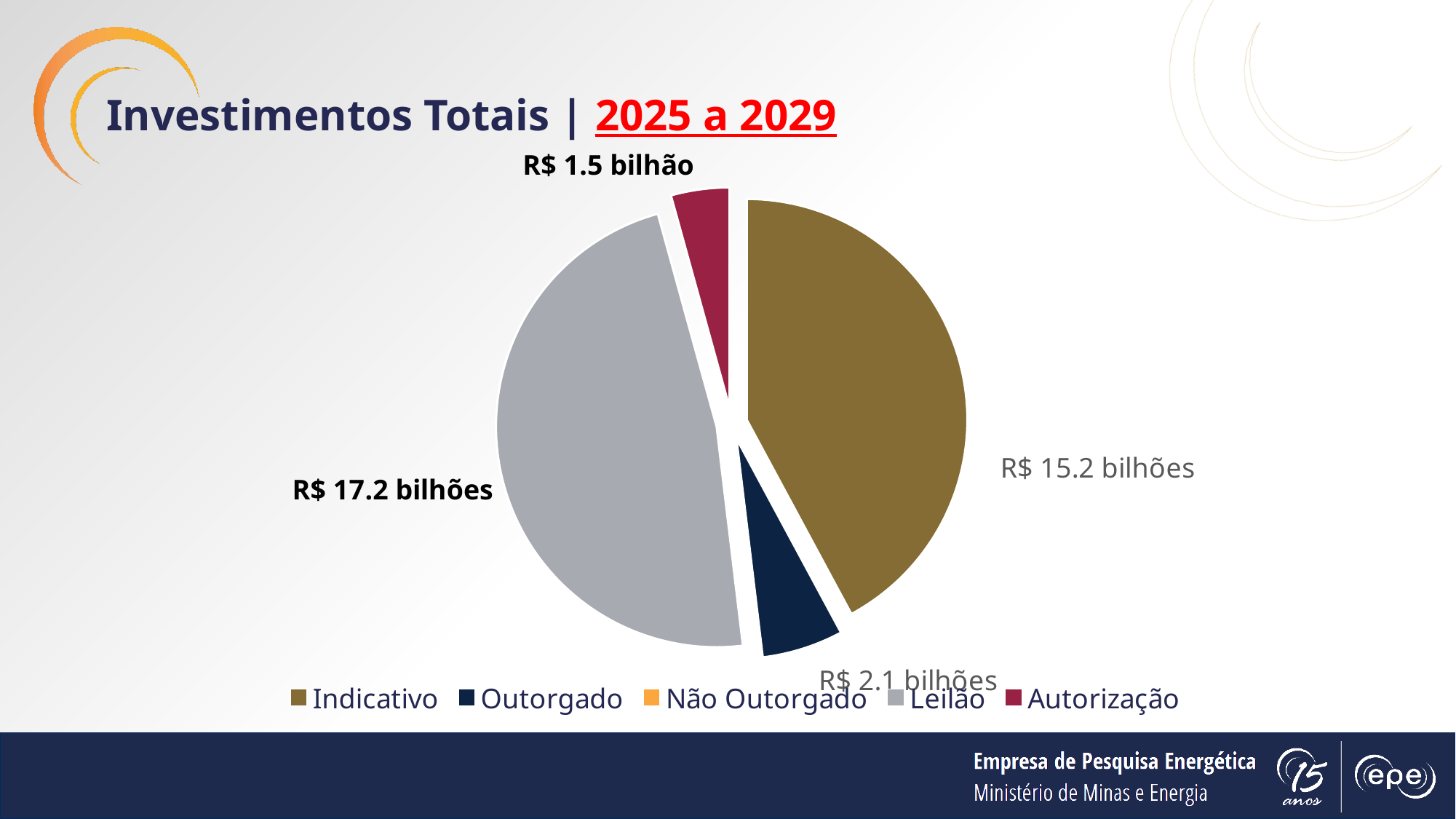
What is the difference between the Leilão and Indicativo values? R$ 2.0 bilhões What is the value of the Leilão slice? R$ 17.2 bilhões What is the value of the Outorgado slice? R$ 2.1 bilhões How many categories does the legend list? 5 What is the title of the chart on the slide? Investimentos Totais | 2025 a 2029 What is the value of the Indicativo slice? R$ 15.2 bilhões Which is larger, the Outorgado slice or the Autorização slice? Outorgado What is the value of the Autorização slice? R$ 1.5 bilhão What type of chart is shown on the slide? pie chart Which labelled category has the smallest visible slice of the pie? Autorização Which category has the largest slice of the pie? Leilão What is the difference between the Indicativo and Outorgado values? R$ 13.1 bilhões